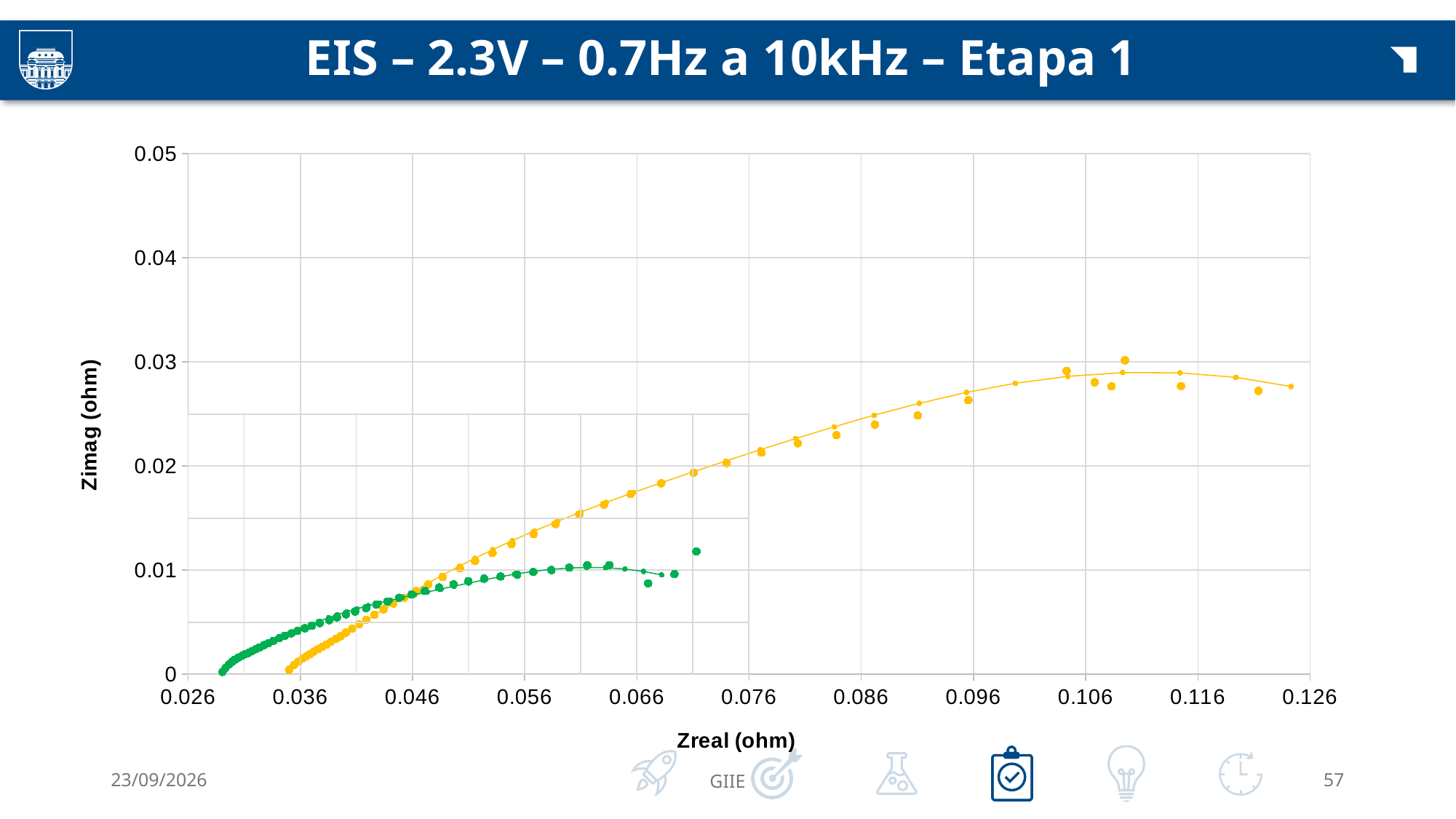
Is the highest Zimag value of the yellow series greater or less than 0.02? greater What is the label of the horizontal axis? Zreal (ohm) What is the maximum value shown on the vertical axis? 0.05 Which series reaches the higher Zimag value, the green one or the yellow one? The yellow one Is the largest Zreal value reached by the green series greater or less than 0.076? less What kind of chart is shown on the slide? Scatter chart What is the title of the chart on the slide? EIS – 2.3V – 0.7Hz a 10kHz – Etapa 1 Is the largest Zreal value reached by the yellow series greater or less than 0.116? greater Which series starts at the lower Zreal value, the green one or the yellow one? The green one